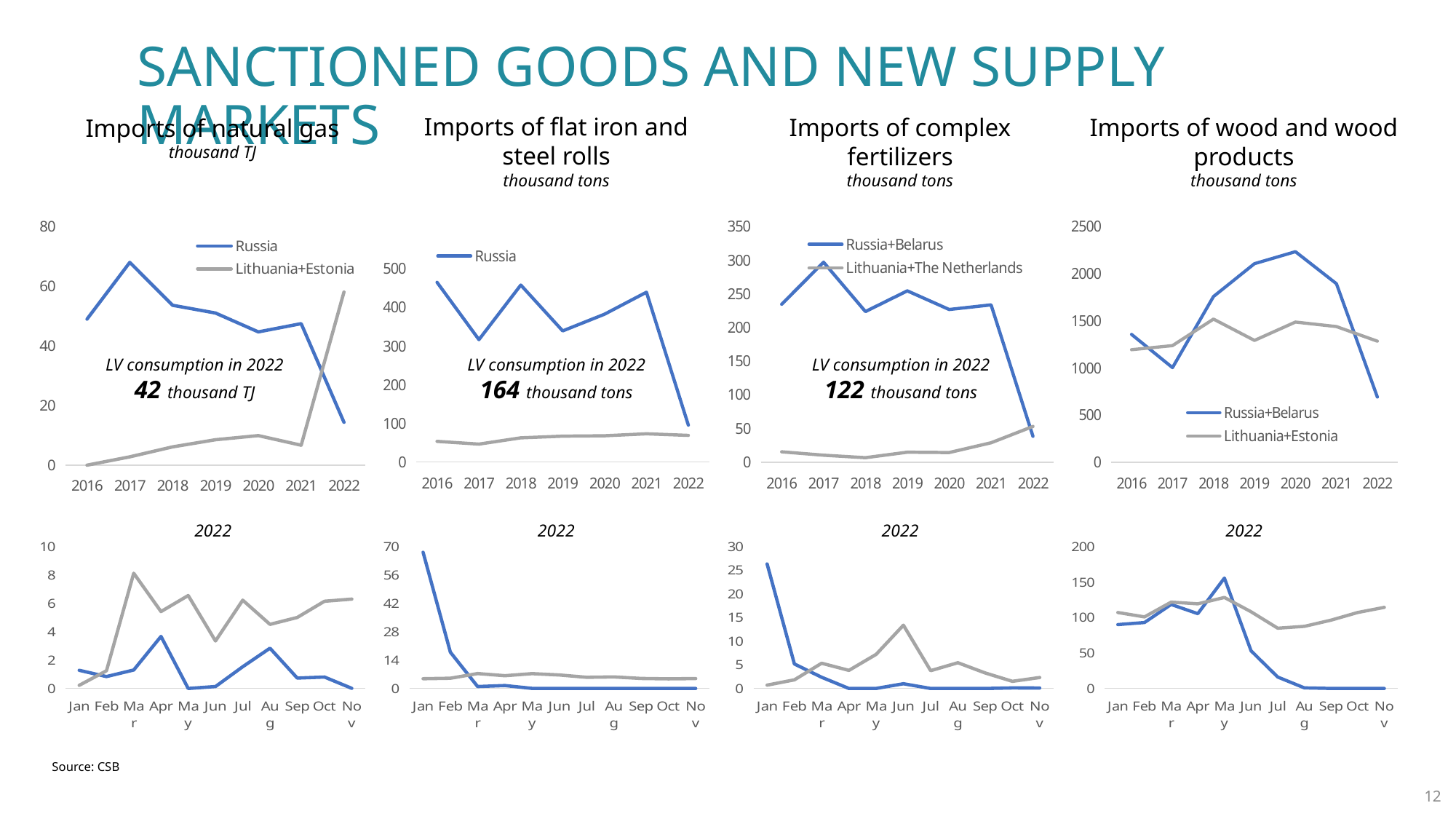
In the annual 'Imports of natural gas' chart, is the Russia value for 2017 greater or less than 60? greater How many years are plotted on the x axis of the annual 'Imports of complex fertilizers' chart? 7 In the annual 'Imports of natural gas' chart, which year has the highest Russia value? 2017 In the annual 'Imports of wood and wood products' chart, which year has the highest Russia+Belarus value? 2020 How many months are plotted on the x axis of the 2022 monthly 'Imports of wood and wood products' chart? 11 What kind of chart is the annual 'Imports of natural gas' chart? line chart How many series does the legend of the 'Imports of flat iron and steel rolls' annual chart list? 1 In the annual 'Imports of wood and wood products' chart, which year has the lowest Russia+Belarus value? 2022 How many series does the legend of the 'Imports of natural gas' annual chart list? 2 What are the two legend entries in the annual 'Imports of complex fertilizers' chart? Russia+Belarus and Lithuania+The Netherlands In the 2022 monthly 'Imports of flat iron and steel rolls' chart, does the Russia line rise or fall from Jan to Nov? fall In the annual 'Imports of flat iron and steel rolls' chart, is the Russia value for 2022 greater or less than 200? less